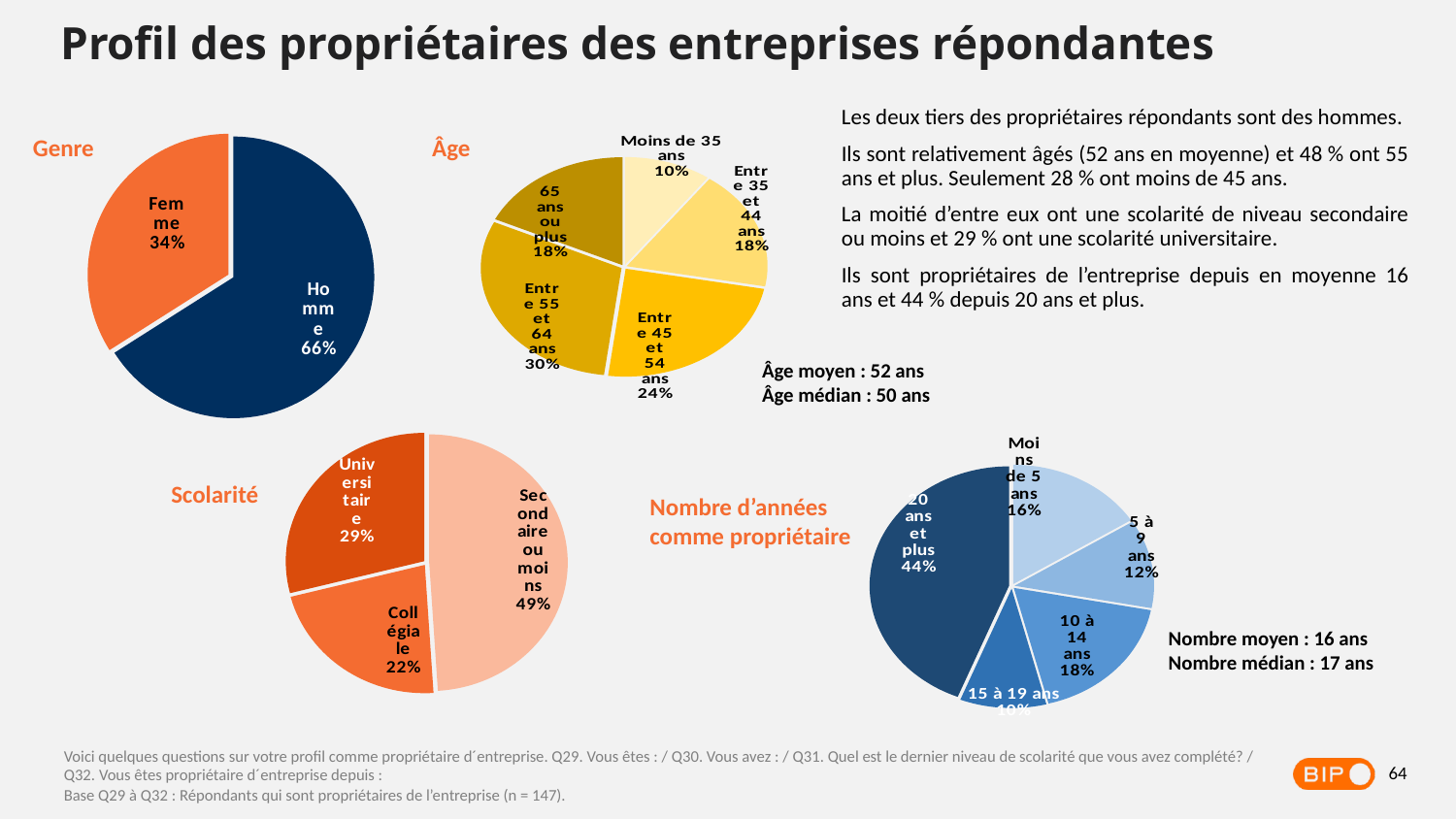
In the Scolarité pie chart, which is larger: Collégiale or Universitaire? Universitaire In the Genre pie chart, what percentage is Femme? 34% In the Nombre d'années comme propriétaire pie chart, what is the difference between Moins de 5 ans and 5 à 9 ans? 4 percentage points In the Scolarité pie chart, what percentage is Universitaire? 29% What type of chart is used for Genre? Pie chart In the Âge pie chart, which age group has the largest share? Entre 55 et 64 ans In the Âge pie chart, which age group has the smallest share? Moins de 35 ans In the Âge pie chart, what percentage is Entre 55 et 64 ans? 30% In the Âge pie chart, how many age categories are shown? 5 In the Genre pie chart, what percentage is Homme? 66% In the Nombre d'années comme propriétaire pie chart, what percentage is 20 ans et plus? 44% In the Scolarité pie chart, what is the difference between Secondaire ou moins and Collégiale? 27 percentage points